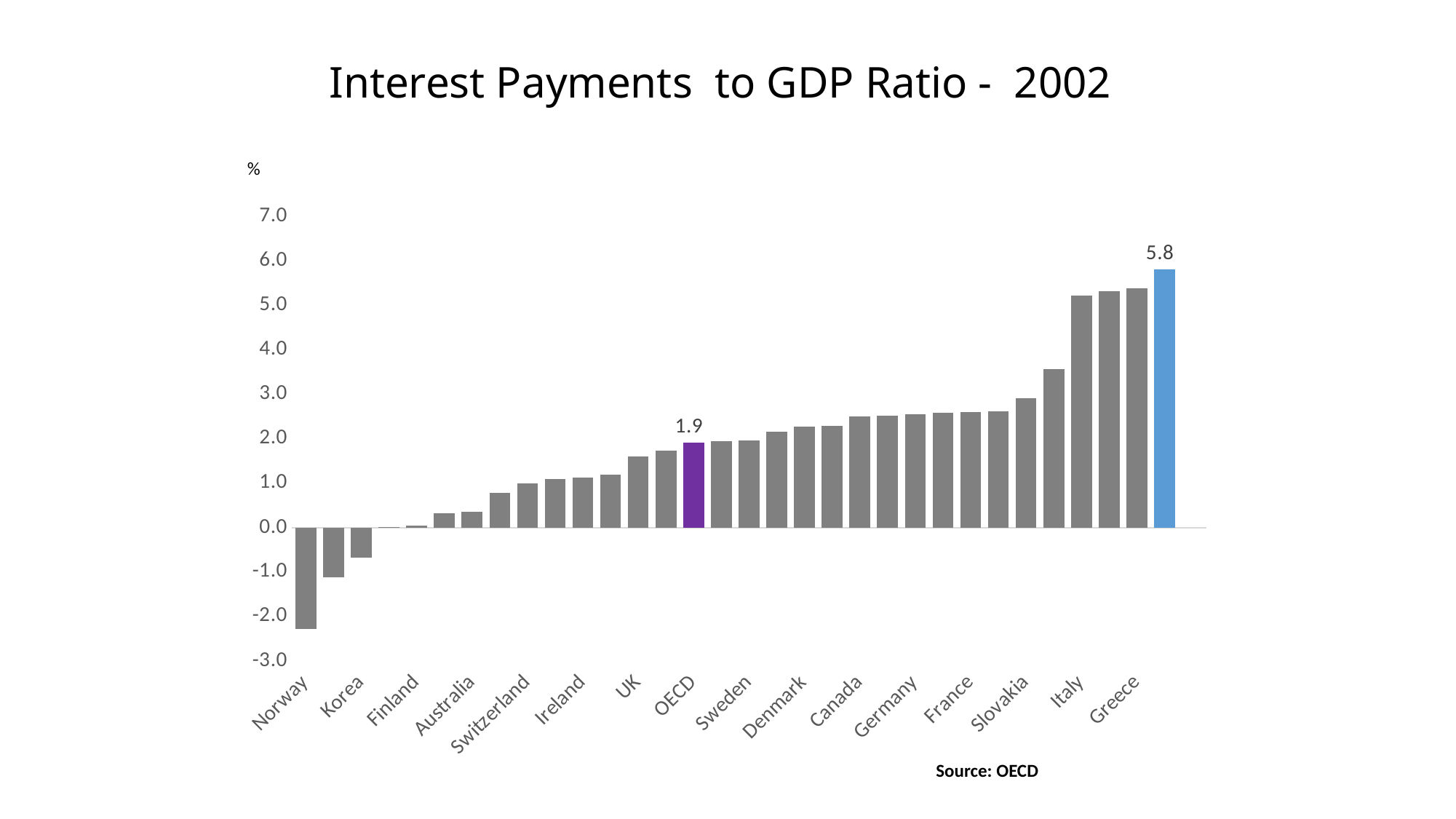
Which category has the lowest interest payments to GDP ratio? Norway What kind of chart is shown on the slide? Bar chart What is the value shown for OECD? 1.9 Is the value for Norway greater or less than -2.0? less How many category labels are shown on the x axis? 16 What colour is the OECD bar? Purple Do the values generally rise or fall from left to right along the x axis? Rise Is the value for Italy greater or less than 4.0? greater Which is larger, the value for Greece or the value for OECD? Greece